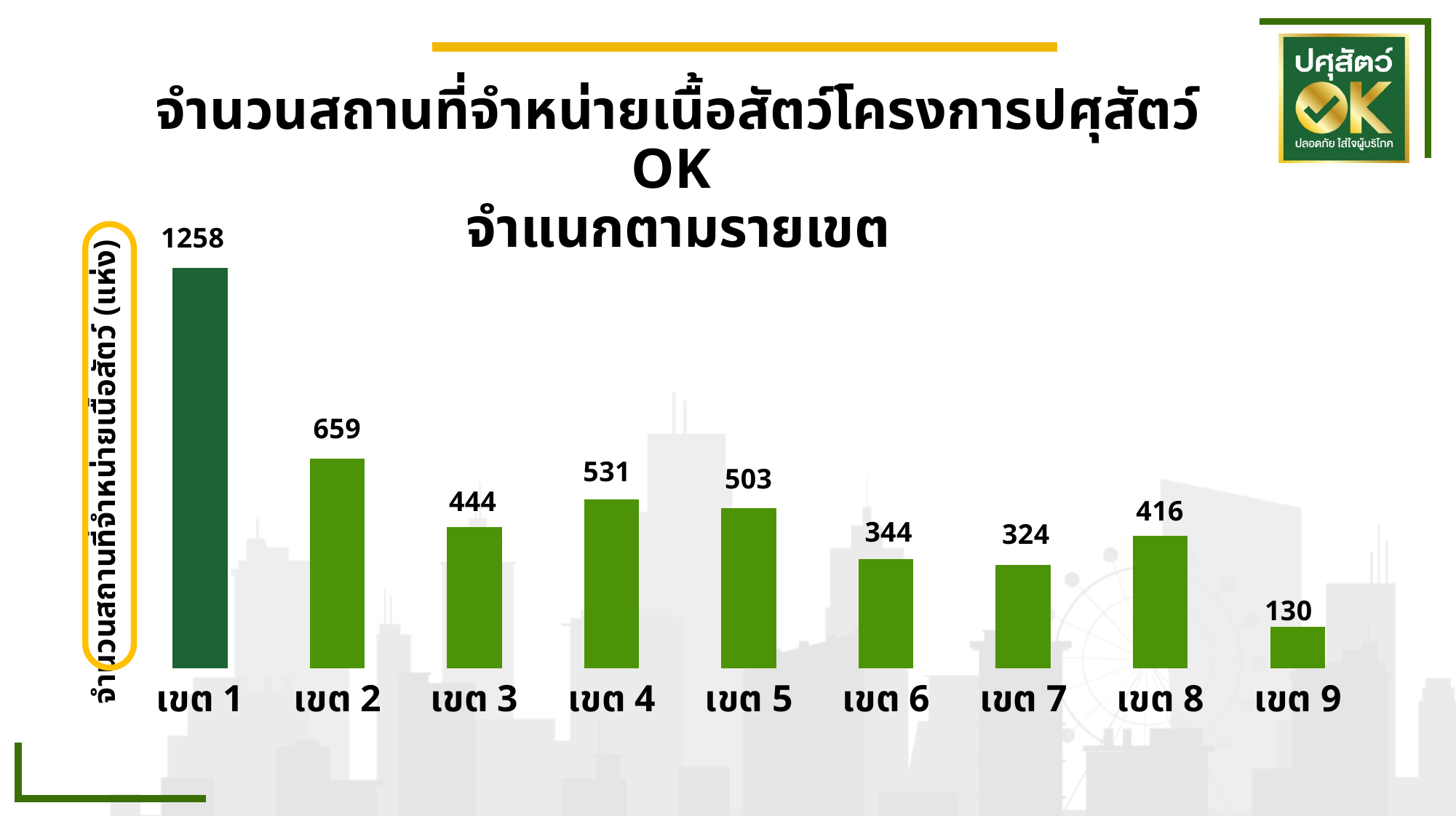
Which bar is shown in a darker green colour than the others? เขต 1 Which is larger, the value for เขต 6 or the value for เขต 7? เขต 6 Which category has the highest value? เขต 1 What is the value for เขต 5? 503 Which is larger, the value for เขต 3 or the value for เขต 8? เขต 3 What kind of chart is shown on the slide? bar chart What is the value for เขต 8? 416 What is the value for เขต 1? 1258 Which category has the lowest value? เขต 9 What is the difference between the values for เขต 1 and เขต 2? 599 What is the difference between the values for เขต 4 and เขต 5? 28 How many categories are shown on the chart? 9